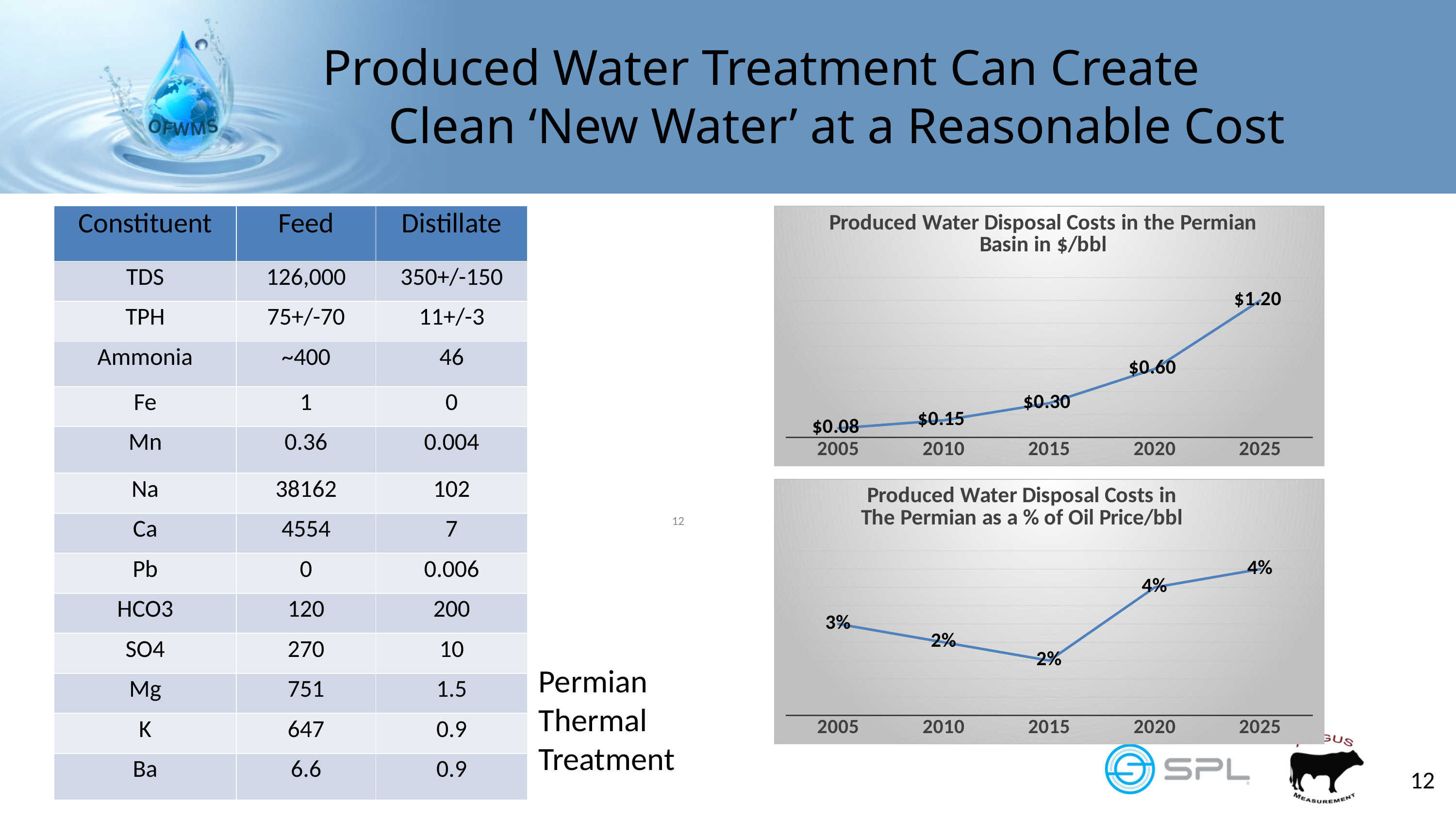
In the chart titled 'Produced Water Disposal Costs in the Permian Basin in $/bbl', what is the difference between the 2025 value and the 2020 value? $0.60 In the chart titled 'Produced Water Disposal Costs in the Permian Basin in $/bbl', what is the value for 2015? $0.30 In the chart titled 'Produced Water Disposal Costs in the Permian Basin in $/bbl', what is the value for 2025? $1.20 How many data points are plotted in the chart titled 'Produced Water Disposal Costs in the Permian Basin in $/bbl'? 5 In the chart titled 'Produced Water Disposal Costs in The Permian as a % of Oil Price/bbl', which is larger, the value for 2005 or the value for 2015? 2005 In the chart titled 'Produced Water Disposal Costs in the Permian Basin in $/bbl', what is the value for 2005? $0.08 In the chart titled 'Produced Water Disposal Costs in The Permian as a % of Oil Price/bbl', what is the value for 2020? 4% In the chart titled 'Produced Water Disposal Costs in the Permian Basin in $/bbl', which year has the highest value? 2025 In the chart titled 'Produced Water Disposal Costs in the Permian Basin in $/bbl', which year has the lowest value? 2005 What kind of chart is the one titled 'Produced Water Disposal Costs in The Permian as a % of Oil Price/bbl'? line chart In the chart titled 'Produced Water Disposal Costs in The Permian as a % of Oil Price/bbl', what is the value for 2005? 3% In the chart titled 'Produced Water Disposal Costs in the Permian Basin in $/bbl', do the values rise or fall from 2005 to 2025? rise